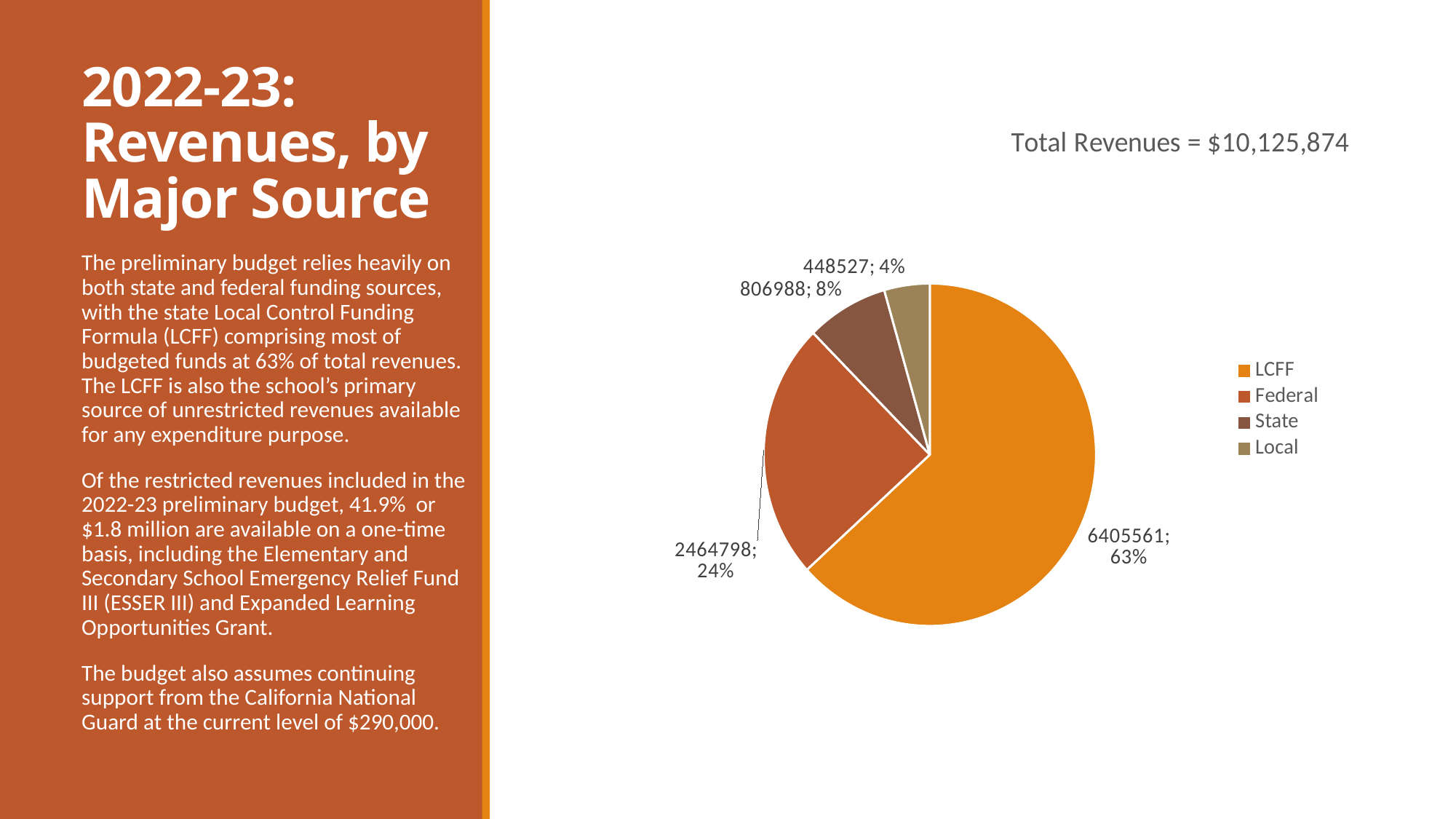
What is the revenue value shown for Local? 448527 What is the revenue value shown for Federal? 2464798 What type of chart is shown on the slide? pie chart Which revenue source is the largest slice of the pie? LCFF How many entries does the legend of the pie chart list? 4 What share of total revenues does Federal represent? 24% What share of total revenues does LCFF represent? 63% What is the revenue value shown for LCFF? 6405561 What is the revenue value shown for State? 806988 How many slices does the pie chart have? 4 What total revenues figure is shown above the pie chart? $10,125,874 Which revenue source is the smallest slice of the pie? Local